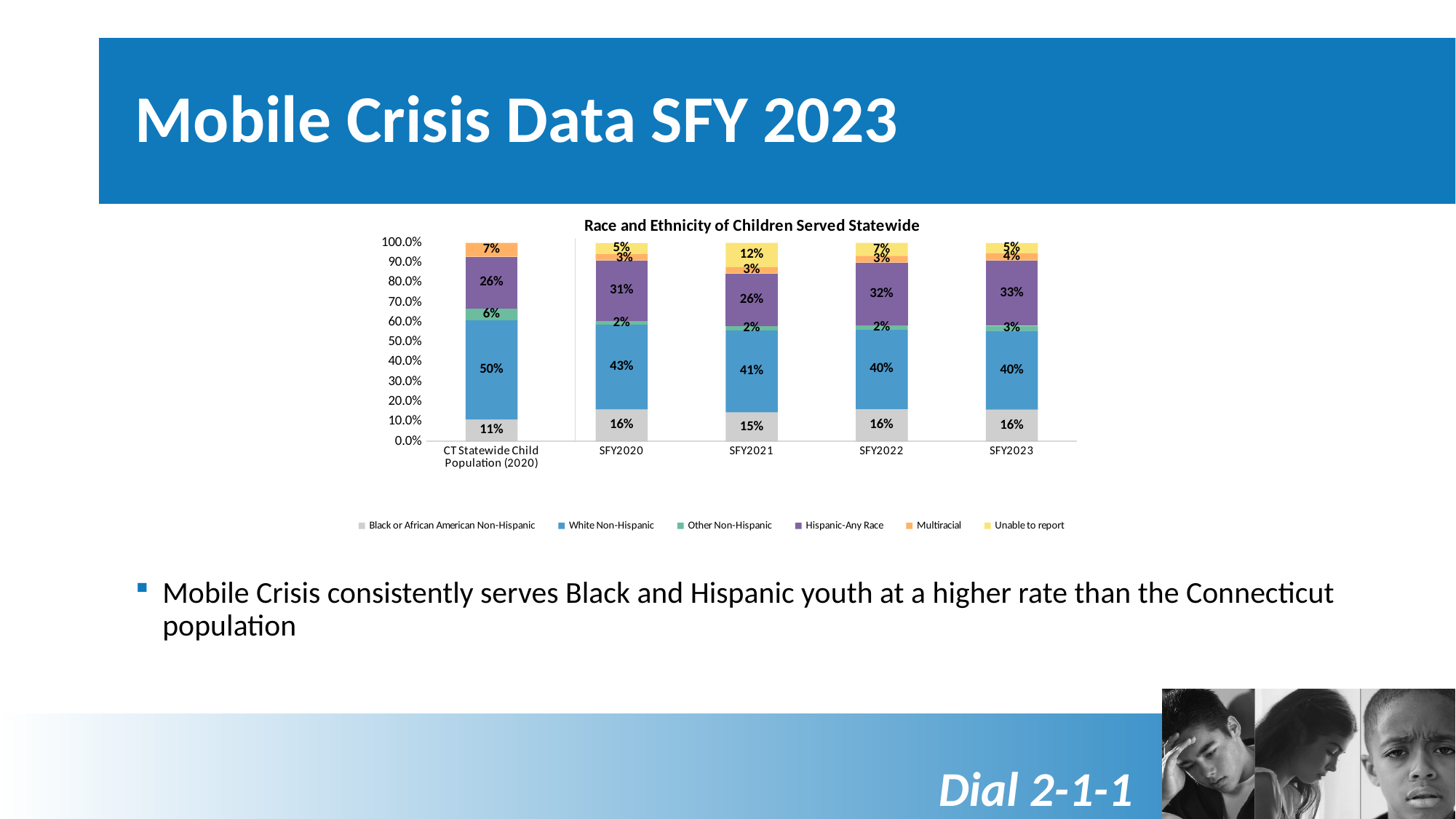
How many series does the legend list? 6 What is the value for White Non-Hispanic in the CT Statewide Child Population (2020) bar? 50% What is the title of the chart? Race and Ethnicity of Children Served Statewide What is the value for Unable to report in SFY2021? 12% What kind of chart is shown? Stacked bar chart How many categories are shown on the x axis? 5 What is the difference between the White Non-Hispanic value for CT Statewide Child Population (2020) and for SFY2023? 10% What is the value for Hispanic-Any Race in SFY2023? 33% What is the value for Black or African American Non-Hispanic in SFY2021? 15% Is the Hispanic-Any Race value larger in SFY2021 or SFY2022? SFY2022 Which category has the highest value for Hispanic-Any Race? SFY2023 Which category has the lowest value for Black or African American Non-Hispanic? CT Statewide Child Population (2020)